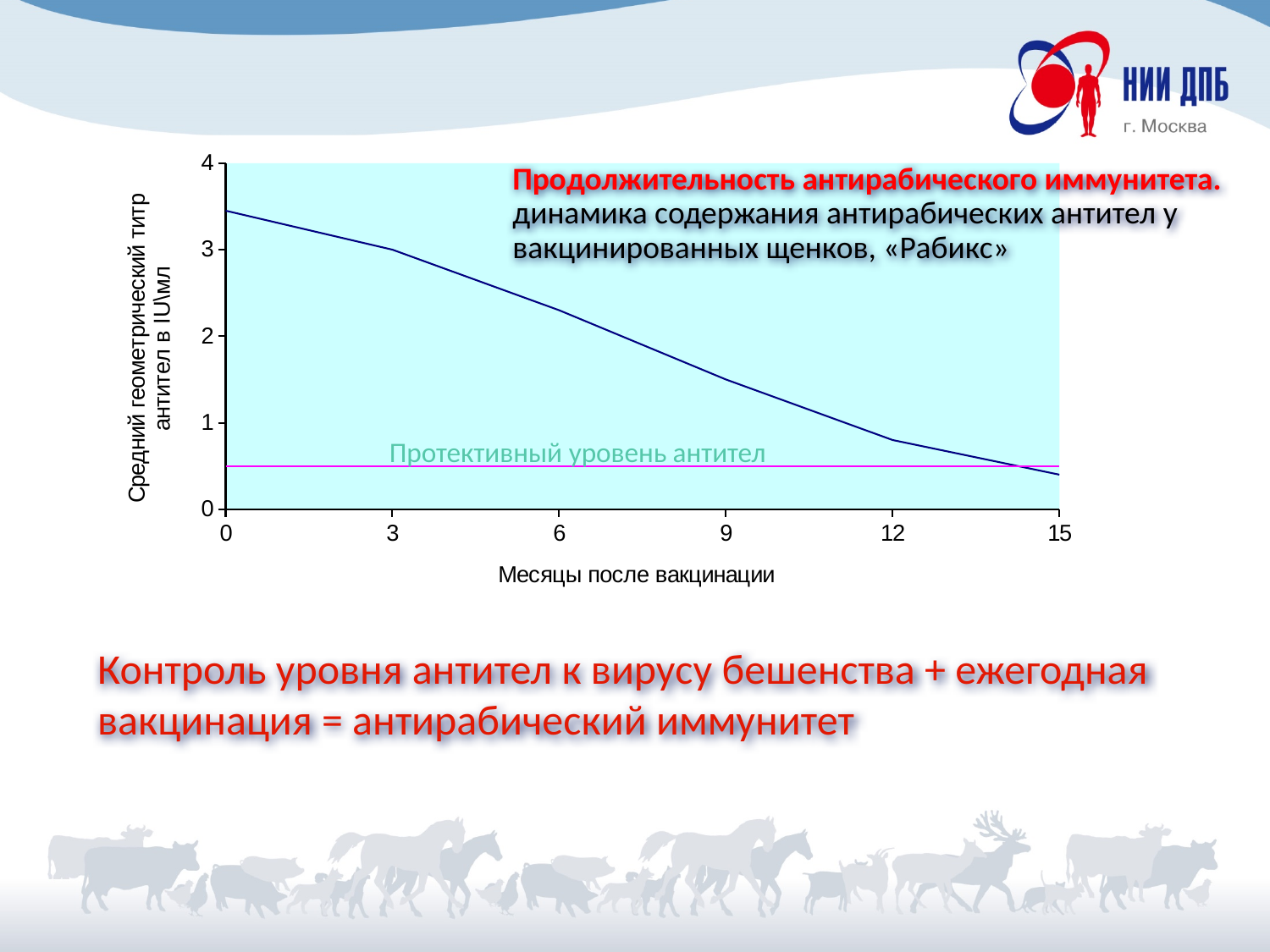
What kind of chart is shown on the slide? line chart Is the antibody titre at 12 months greater or less than 1? less At which month after vaccination is the antibody titre highest? 0 Is the antibody titre at 0 months greater or less than 3? greater What is the label of the x axis? Месяцы после вакцинации Does the antibody titre rise or fall as the months after vaccination increase? fall Is the antibody titre at 6 months greater or less than 2? greater At which month after vaccination is the antibody titre lowest? 15 What does the horizontal magenta line on the chart represent? Протективный уровень антител Which is larger, the antibody titre at 3 months or at 12 months? 3 months